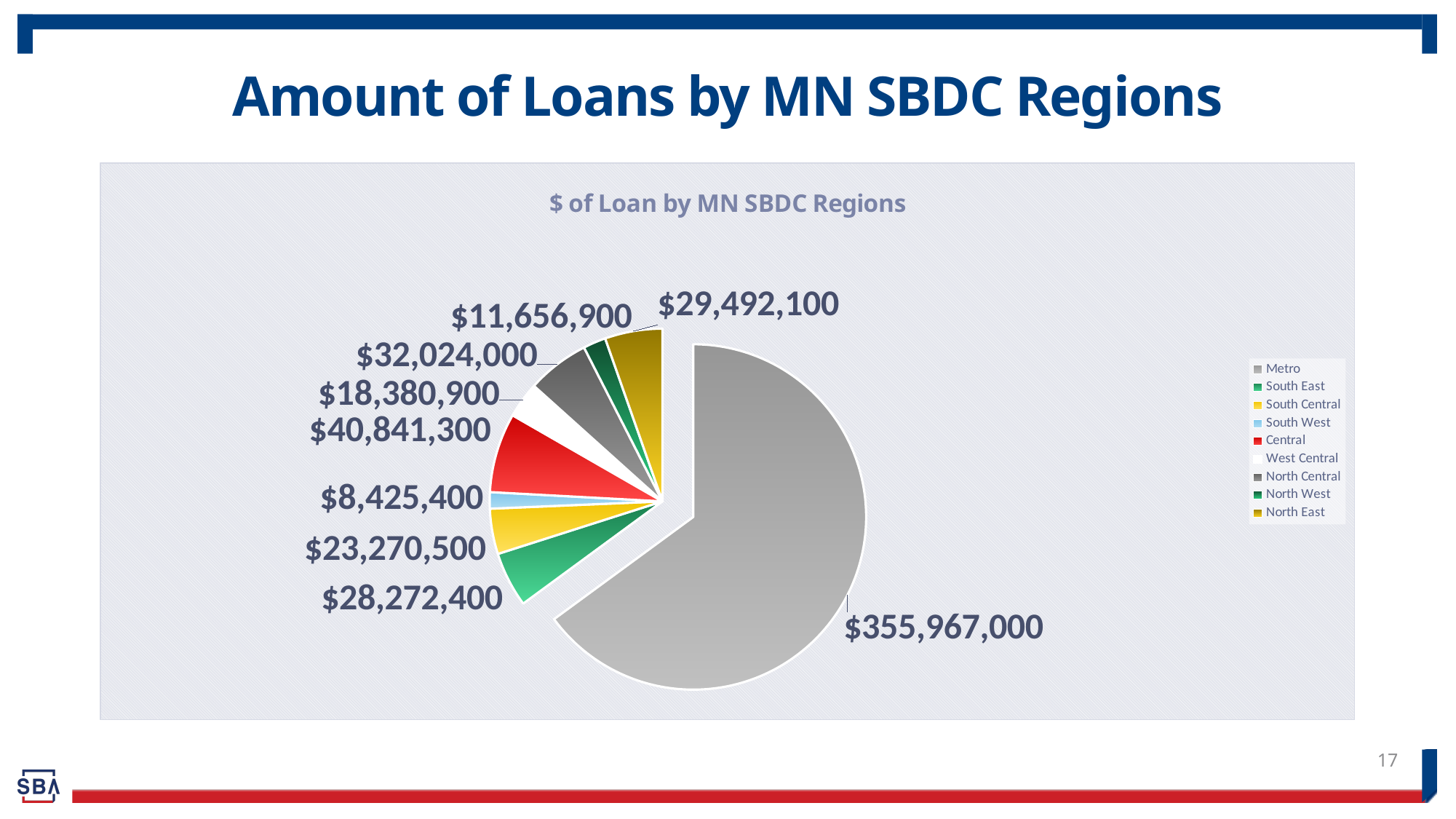
What is the loan amount for the North East region? $29,492,100 Which region has the largest loan amount? Metro What is the loan amount for the Metro region? $355,967,000 What type of chart is shown on the slide? Pie chart What is the difference between the loan amounts for North Central and North West? $20,367,100 How many regions are shown in the pie chart? 9 Which region has the smallest loan amount? South West What is the loan amount for the Central region? $40,841,300 Which region has a larger loan amount, South East or South Central? South East What is the difference between the loan amounts for Central and South West? $32,415,900 What is the loan amount for the South West region? $8,425,400 What is the title of the chart inside the plot area? $ of Loan by MN SBDC Regions